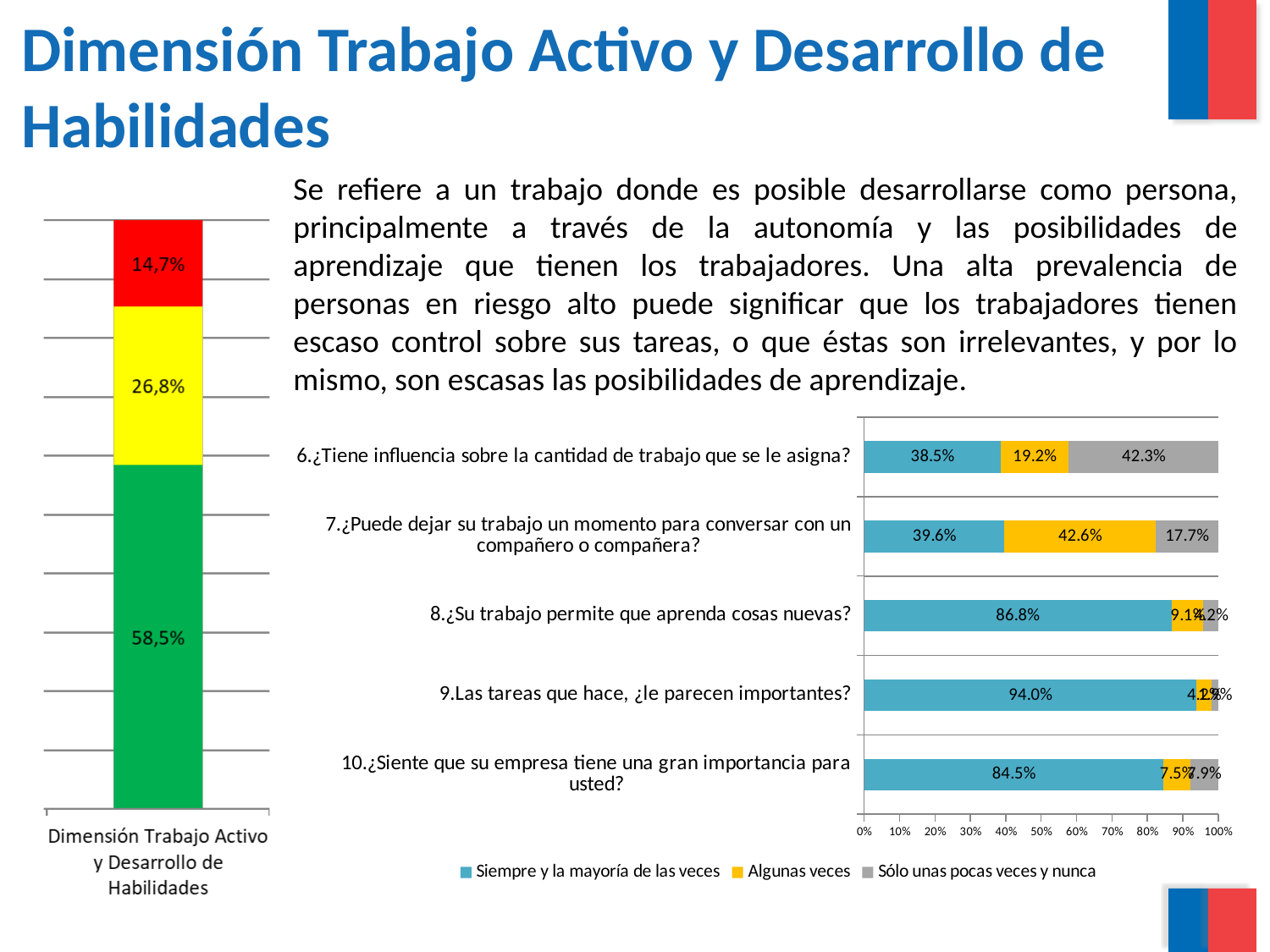
In the left chart, which segment is the largest? The green segment (58,5%) What type of chart is the chart on the right? Stacked horizontal bar chart In the right chart, how many series does the legend list? 3 In the right chart, which question has the highest 'Siempre y la mayoría de las veces' value? 9.Las tareas que hace, ¿le parecen importantes? (94.0%) In the right chart, what is the 'Sólo unas pocas veces y nunca' value for question 6? 42.3% In the left chart, what is the value of the green segment of the bar? 58,5% In the left chart, what is the value of the red segment at the top of the bar? 14,7% In the right chart, what is the 'Algunas veces' value for question 7 (¿Puede dejar su trabajo un momento para conversar con un compañero o compañera?)? 42.6% In the left chart, what is the difference between the green segment and the yellow segment? 31,7% In the left chart, what is the category label under the bar? Dimensión Trabajo Activo y Desarrollo de Habilidades In the right chart, how many questions (categories) are plotted? 5 In the right chart, what is the 'Siempre y la mayoría de las veces' value for question 6 (¿Tiene influencia sobre la cantidad de trabajo que se le asigna?)? 38.5%